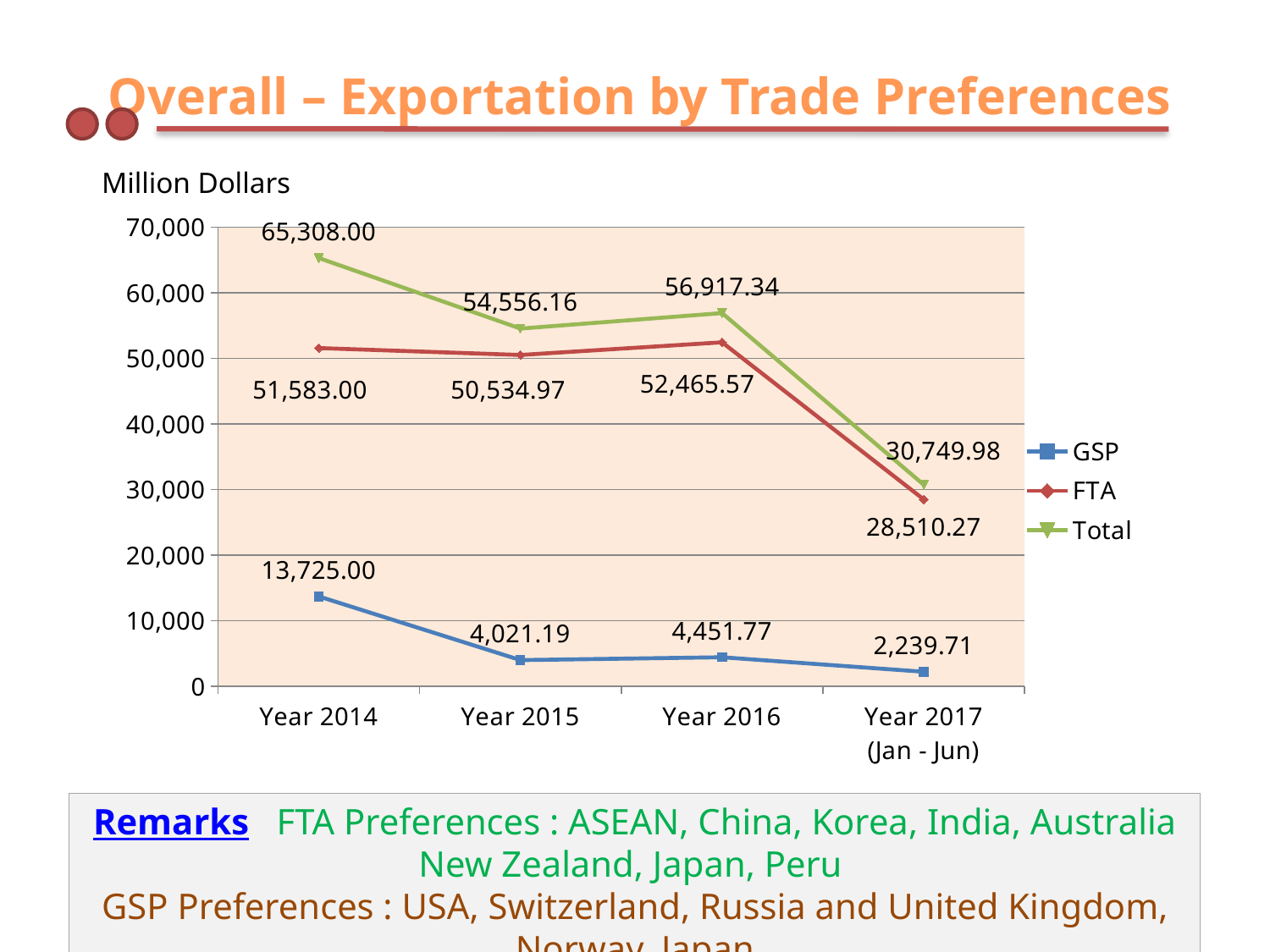
Does the Total series rise or fall from Year 2016 to Year 2017 (Jan - Jun)? fall What kind of chart is shown on the slide? line chart In which year is the FTA value lowest? Year 2017 (Jan - Jun) How many year categories are shown on the x axis? 4 What unit is stated above the chart? Million Dollars How many series does the legend list? 3 What is the GSP value for Year 2017 (Jan - Jun)? 2,239.71 In which year is the GSP value highest? Year 2014 Which is larger, the GSP value for Year 2015 or the GSP value for Year 2016? Year 2016 What is the difference between the Total and FTA values for Year 2015? 4,021.19 What is the Total value for Year 2014? 65,308.00 What is the FTA value for Year 2016? 52,465.57